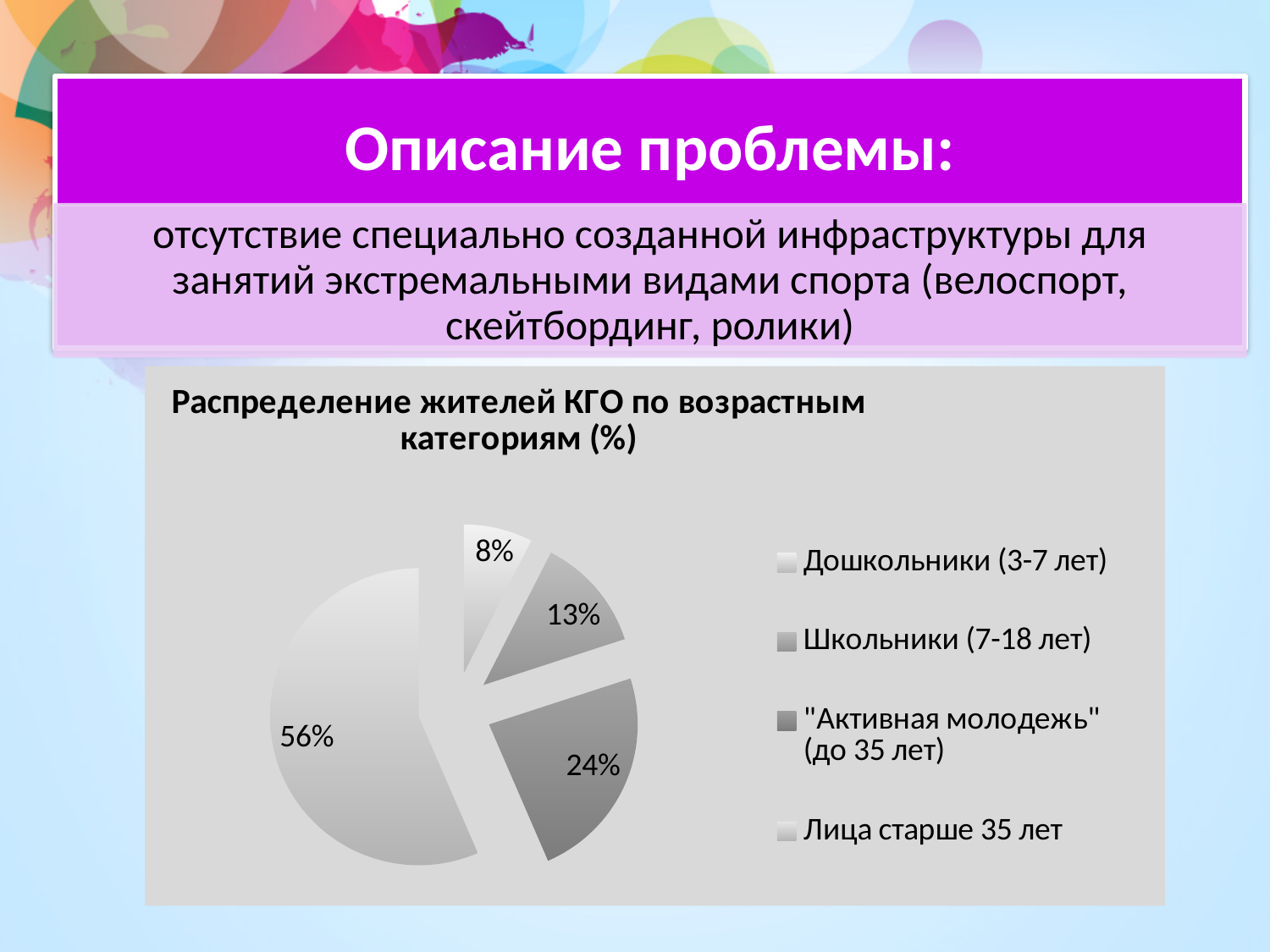
How many slices does the pie chart have? 4 Which category has the largest slice of the pie? Лица старше 35 лет Which category has the smallest slice of the pie? Дошкольники (3-7 лет) What is the title of the chart? Распределение жителей КГО по возрастным категориям (%) What share of the pie is labelled for "Активная молодежь" (до 35 лет)? 24% What is the difference in percentage points between the slices for Лица старше 35 лет and "Активная молодежь" (до 35 лет)? 32 Which slice is larger: Школьники (7-18 лет) or "Активная молодежь" (до 35 лет)? "Активная молодежь" (до 35 лет) What share of the pie is labelled for Школьники (7-18 лет)? 13% What share of the pie is labelled for Лица старше 35 лет? 56% What share of the pie is labelled for Дошкольники (3-7 лет)? 8% How many categories does the legend of the pie chart list? 4 What kind of chart is shown on the slide? pie chart